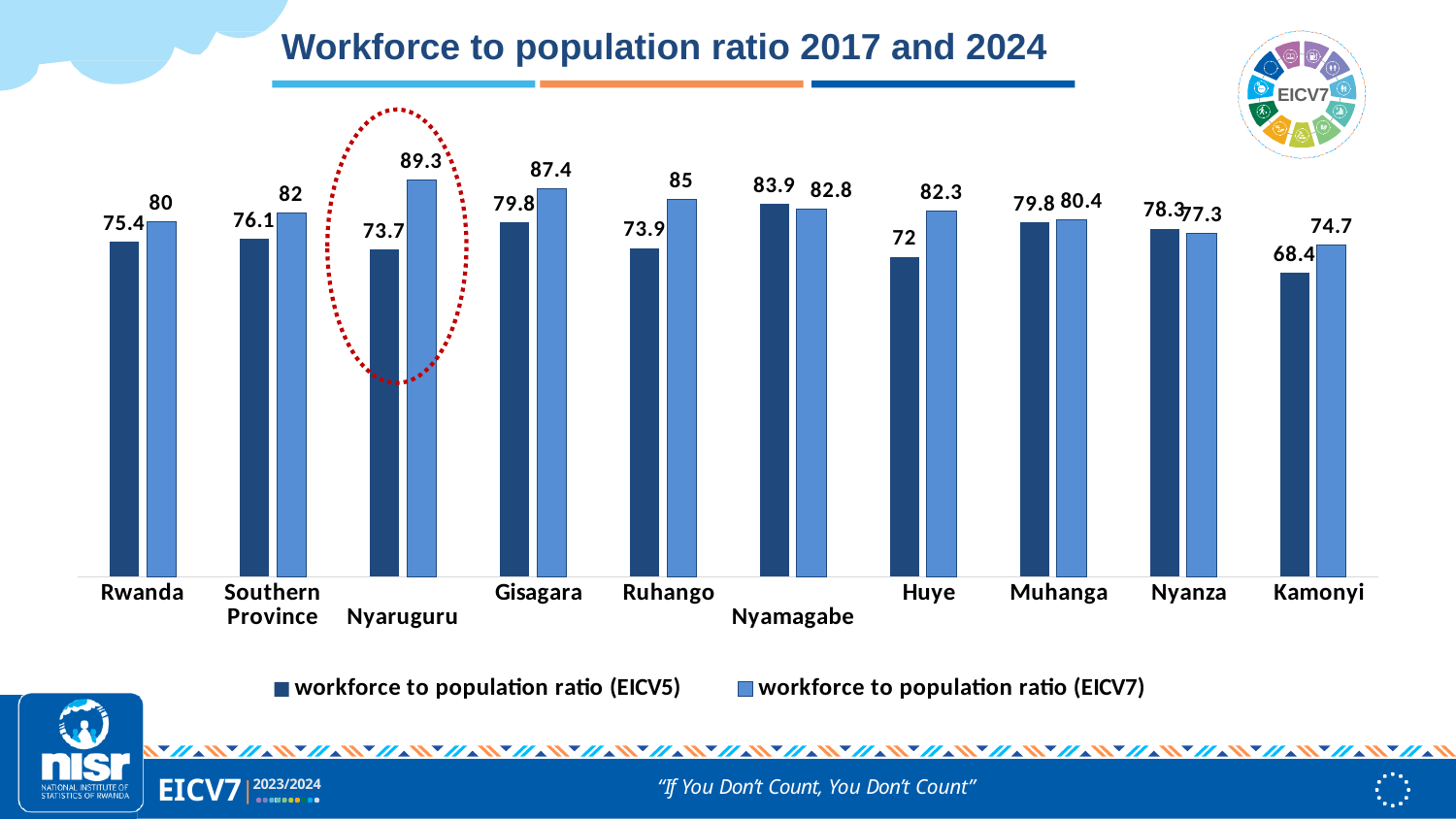
What is the workforce to population ratio (EICV7) for Nyaruguru? 89.3 Which category has the highest workforce to population ratio (EICV5)? Nyamagabe What is the workforce to population ratio (EICV7) for Rwanda? 80 What is the workforce to population ratio (EICV5) for Huye? 72 Which district has the highest workforce to population ratio (EICV7)? Nyaruguru What kind of chart is shown on the slide? Bar chart Which category has the lowest workforce to population ratio (EICV5)? Kamonyi What is the difference between the EICV7 and EICV5 workforce to population ratios for Nyaruguru? 15.6 How many categories are shown on the x axis? 10 For Nyamagabe, which is larger: the EICV5 ratio or the EICV7 ratio? EICV5 How many series does the legend list? 2 What is the difference between the EICV7 and EICV5 workforce to population ratios for Huye? 10.3